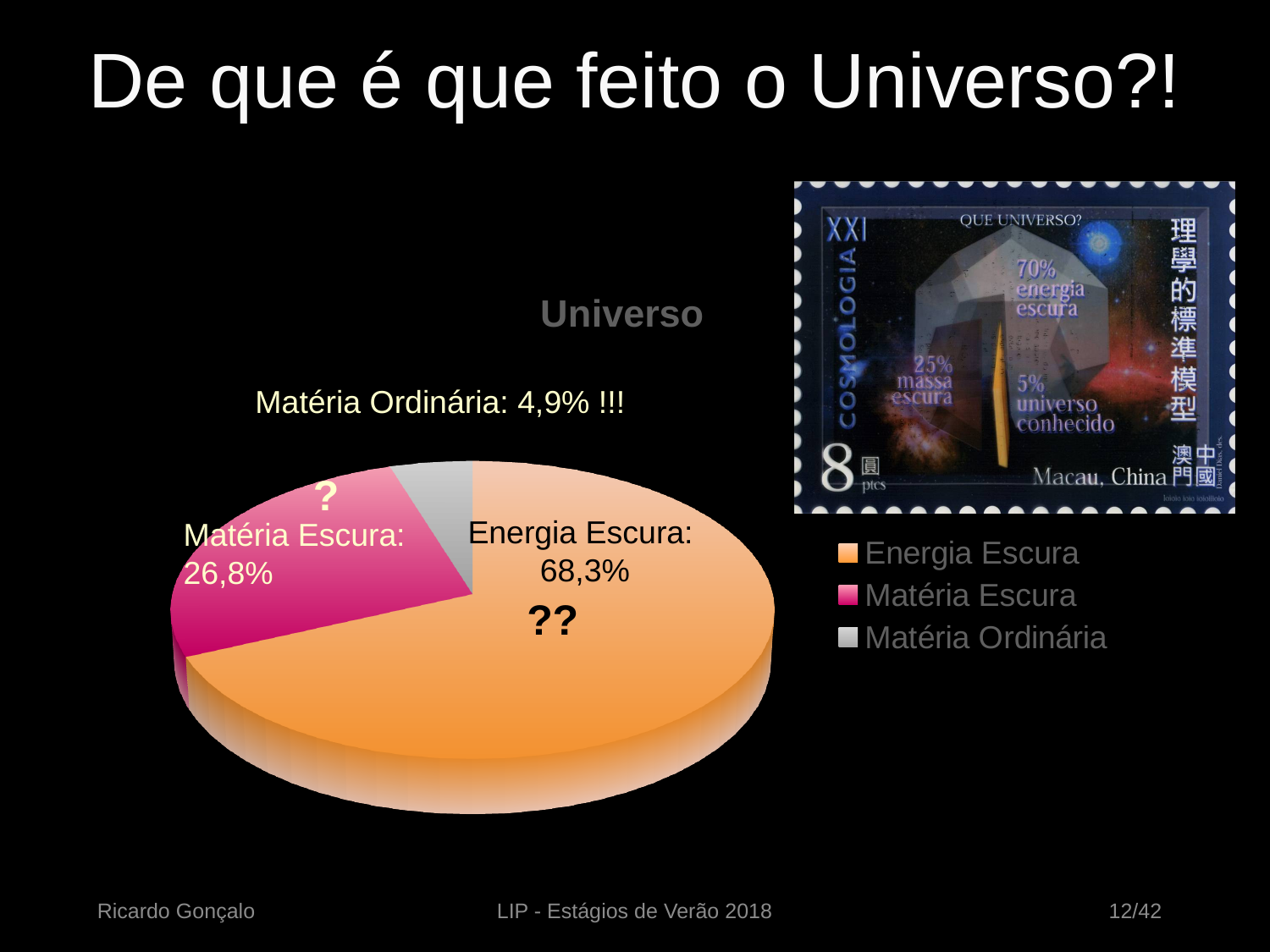
What share of the pie does Matéria Escura have? 26,8% What share of the pie does Energia Escura have? 68,3% What share of the pie does Matéria Ordinária have? 4,9% What is the difference between the Energia Escura and Matéria Escura shares? 41,5% Which is larger, the Matéria Escura slice or the Matéria Ordinária slice? Matéria Escura What kind of chart is shown on the slide? pie chart How many slices does the pie chart have? 3 Which slice of the pie chart is the smallest? Matéria Ordinária What is the difference between the Matéria Escura and Matéria Ordinária shares? 21,9% Which slice of the pie chart is the largest? Energia Escura How many entries does the legend list? 3 What is the title of the pie chart? Universo